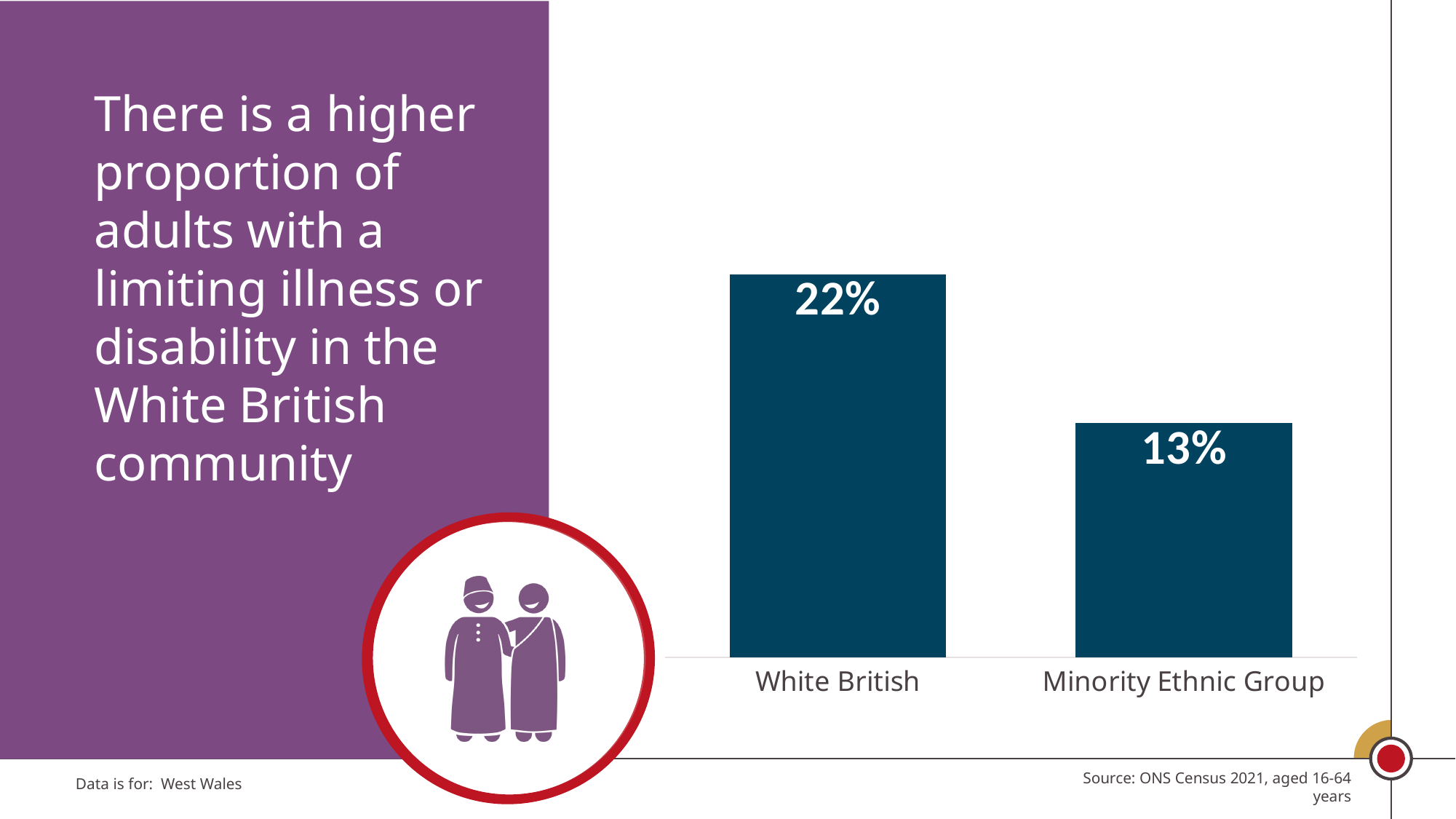
How many categories are shown in the chart? 2 Do the values rise or fall from left to right along the x axis? Fall Which category has the lowest value? Minority Ethnic Group What is the value for Minority Ethnic Group? 13% What colour are the bars in the chart? Dark blue Which is larger, the value for White British or the value for Minority Ethnic Group? White British What is the value for White British? 22% Which category has the highest value? White British What kind of chart is shown on the slide? Bar chart What is the difference between the values for White British and Minority Ethnic Group? 9% According to the source note, which census is the chart data from? ONS Census 2021